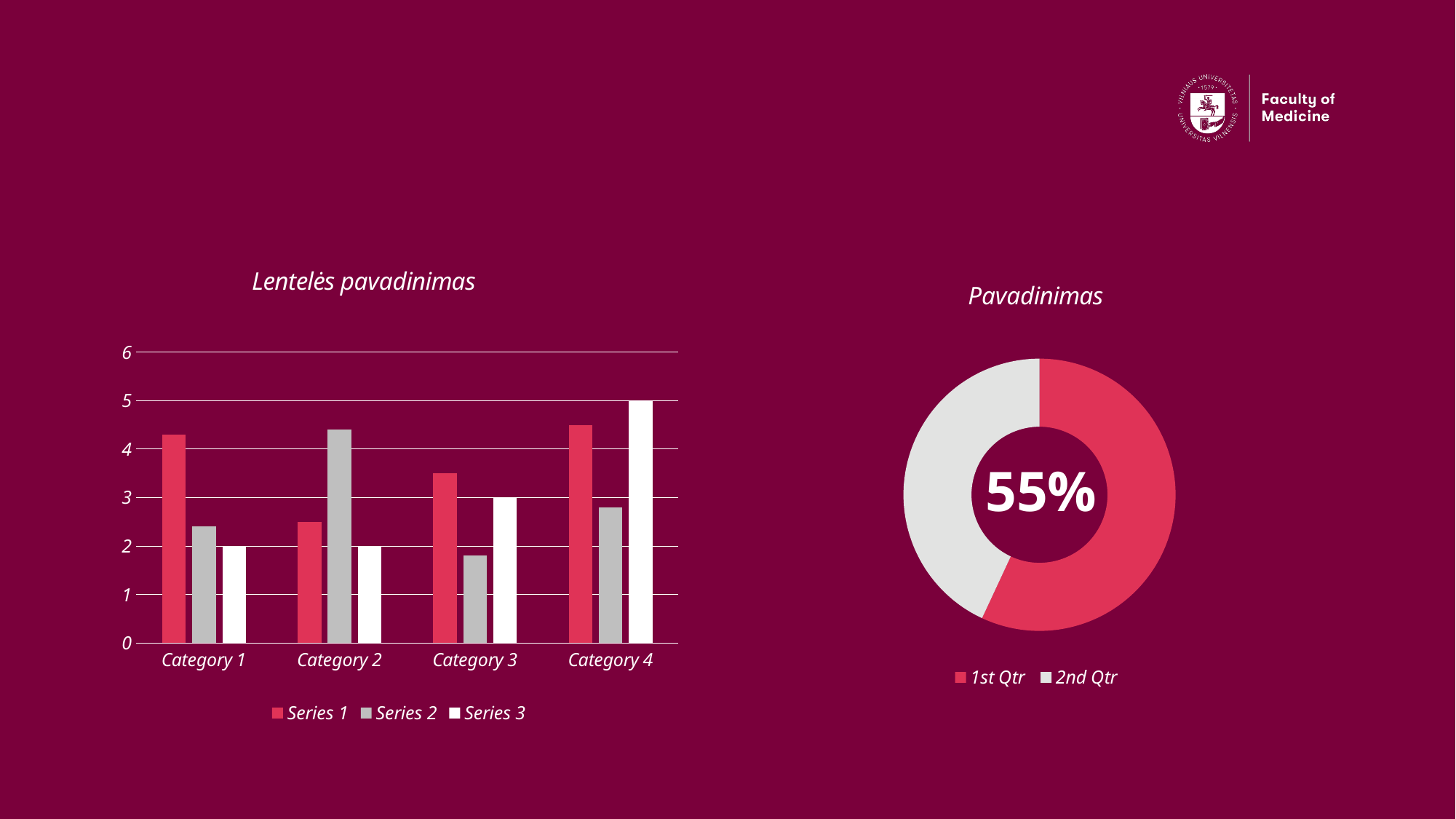
In the chart titled "Lentelės pavadinimas", how many categories are shown on the x axis? 4 In the chart titled "Lentelės pavadinimas", which category has the lowest value for Series 2? Category 3 In the chart titled "Lentelės pavadinimas", is the value of Series 1 for Category 1 greater or less than 4? greater What kind of chart is the chart titled "Pavadinimas"? doughnut chart What kind of chart is the chart titled "Lentelės pavadinimas"? bar chart In the chart titled "Lentelės pavadinimas", how many series does the legend list? 3 In the chart titled "Lentelės pavadinimas", which category has the highest value for Series 3? Category 4 In the chart titled "Lentelės pavadinimas", what is the value of Series 3 for Category 4? 5 In the chart titled "Pavadinimas", how many entries does the legend list? 2 In the chart titled "Pavadinimas", what share does the 1st Qtr slice represent? 55% In the chart titled "Lentelės pavadinimas", what is the value of Series 3 for Category 1? 2 In the chart titled "Lentelės pavadinimas", for Category 2, which is larger: Series 1 or Series 2? Series 2